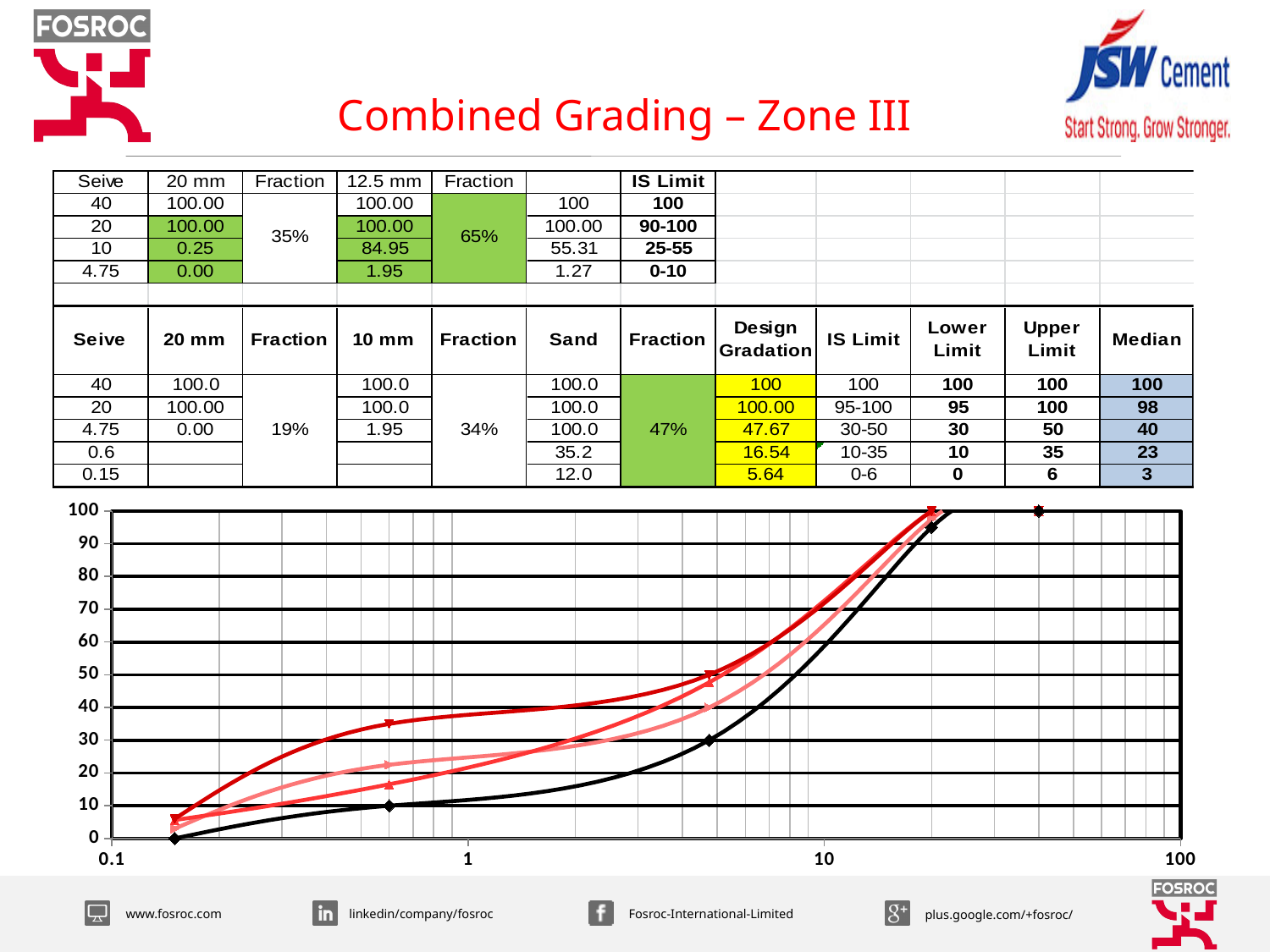
Do the plotted lines rise or fall as the x axis increases from 0.1 to 100? rise Is the value of the black line at x = 10 greater or less than 40? greater Is the value of the black line at x = 1 greater or less than 20? less What is the highest value shown on the y axis of the chart? 100 How many lines are plotted on the chart? 4 What is the spacing between consecutive y-axis tick labels on the chart? 10 What kind of chart is shown at the bottom of the slide? line chart At x = 1, is the black line or the dark red line higher? the dark red line How many tick labels are shown on the x axis of the chart? 4 What is the lowest tick label shown on the x axis of the chart? 0.1 Which line has the lowest value at x = 1? the black line